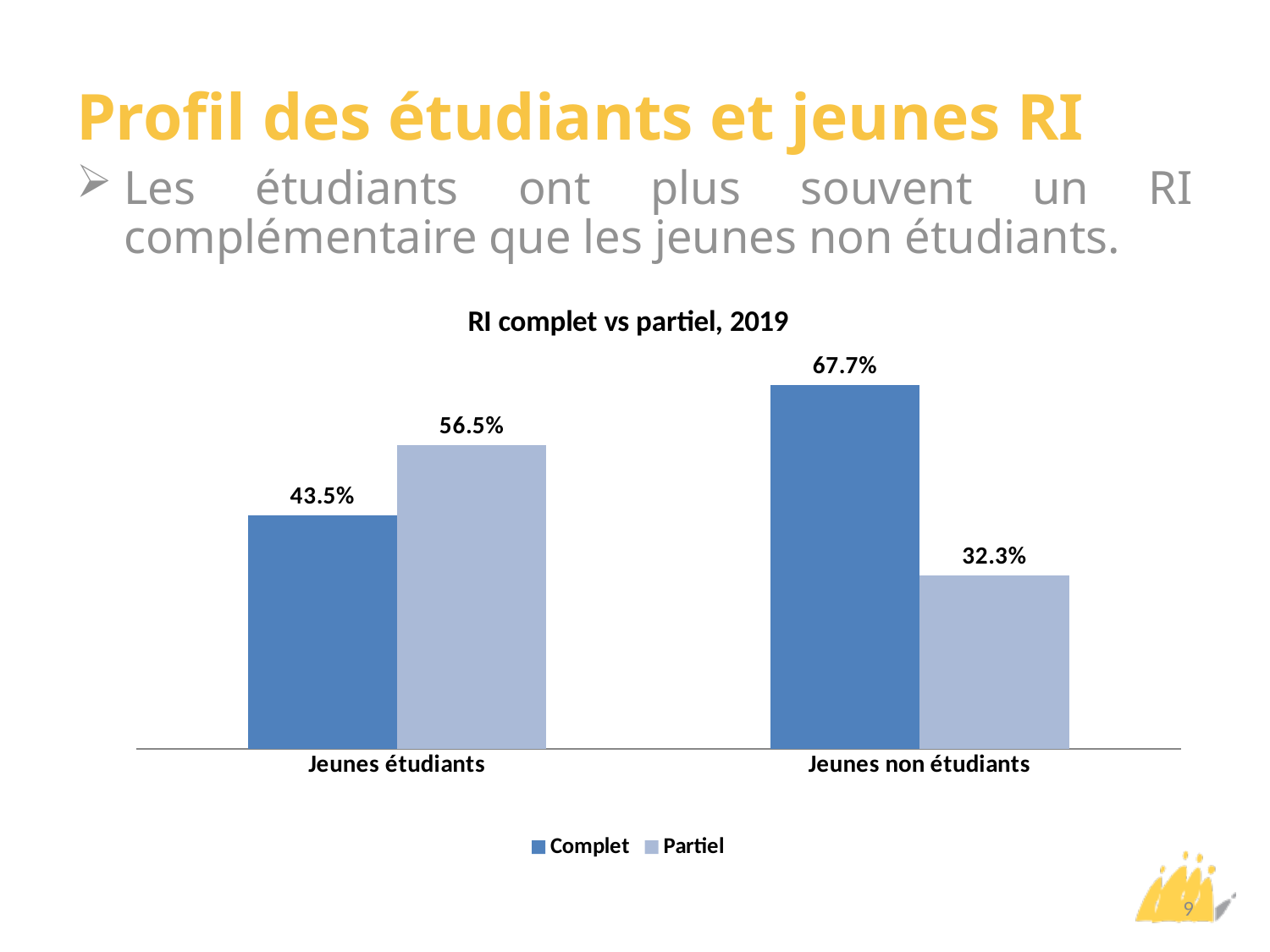
Which category has the highest Complet value? Jeunes non étudiants How many categories are shown on the x axis? 2 What is the value of Complet for Jeunes étudiants? 43.5% How many series does the legend list? 2 Which is larger for Jeunes étudiants, Complet or Partiel? Partiel What is the value of Partiel for Jeunes non étudiants? 32.3% What is the value of Complet for Jeunes non étudiants? 67.7% Which category has the lowest Partiel value? Jeunes non étudiants What is the value of Partiel for Jeunes étudiants? 56.5% What is the title of the chart? RI complet vs partiel, 2019 What is the difference between the Complet values for Jeunes non étudiants and Jeunes étudiants? 24.2% What kind of chart is shown on the slide? Bar chart